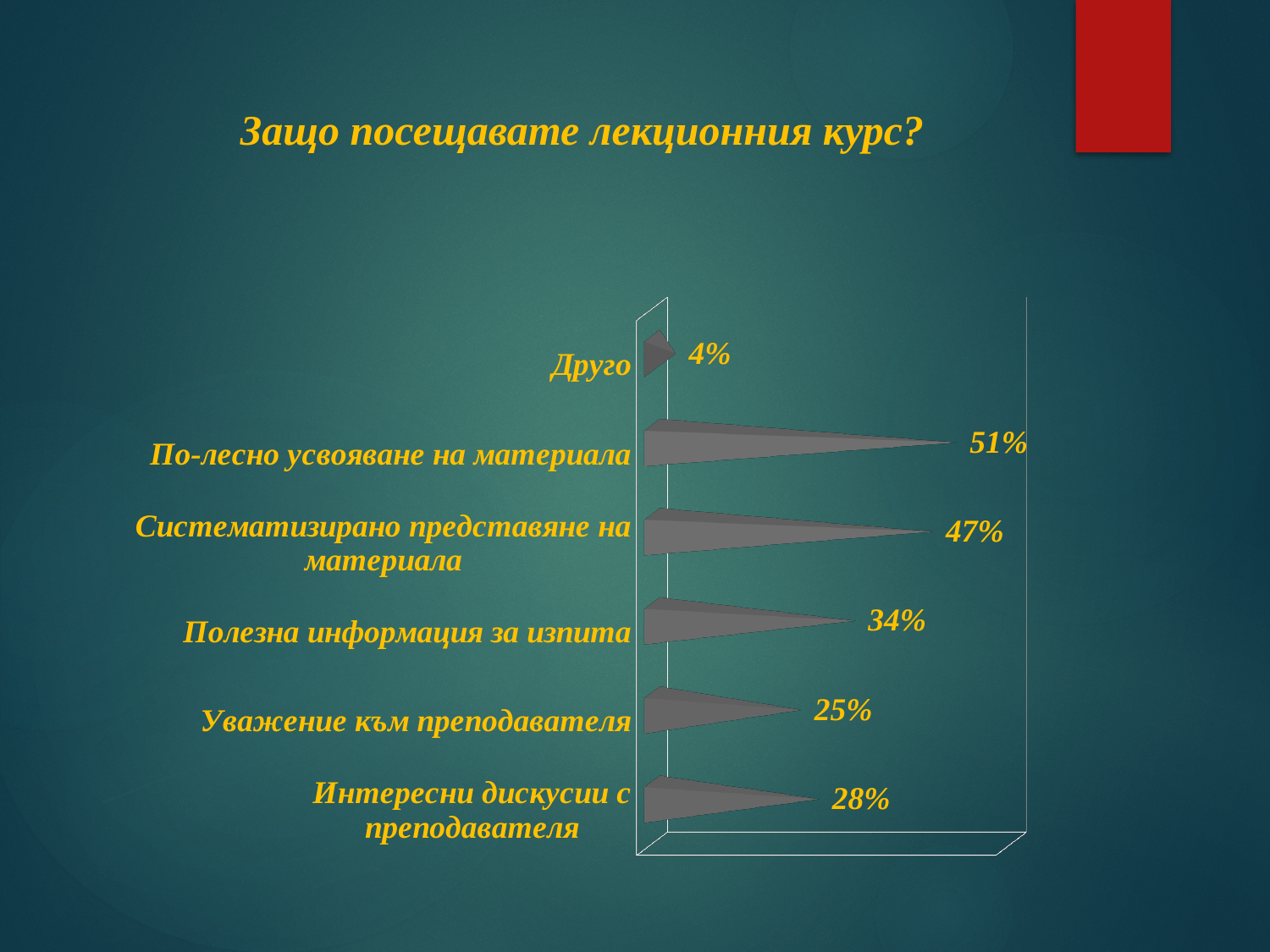
What is the value for "Интересни дискусии с преподавателя"? 28% What is the title of the slide above the chart? Защо посещавате лекционния курс? What kind of chart is shown on the slide? Bar chart What is the difference between the values for "По-лесно усвояване на материала" and "Систематизирано представяне на материала"? 4% How many categories are shown in the chart? 6 What is the value for "Друго"? 4% Which category has the highest value? По-лесно усвояване на материала Which category has the lowest value? Друго Which is larger: the value for "Интересни дискусии с преподавателя" or the value for "Уважение към преподавателя"? Интересни дискусии с преподавателя What is the value for "По-лесно усвояване на материала"? 51% What is the difference between the values for "Полезна информация за изпита" and "Уважение към преподавателя"? 9% What is the value for "Уважение към преподавателя"? 25%